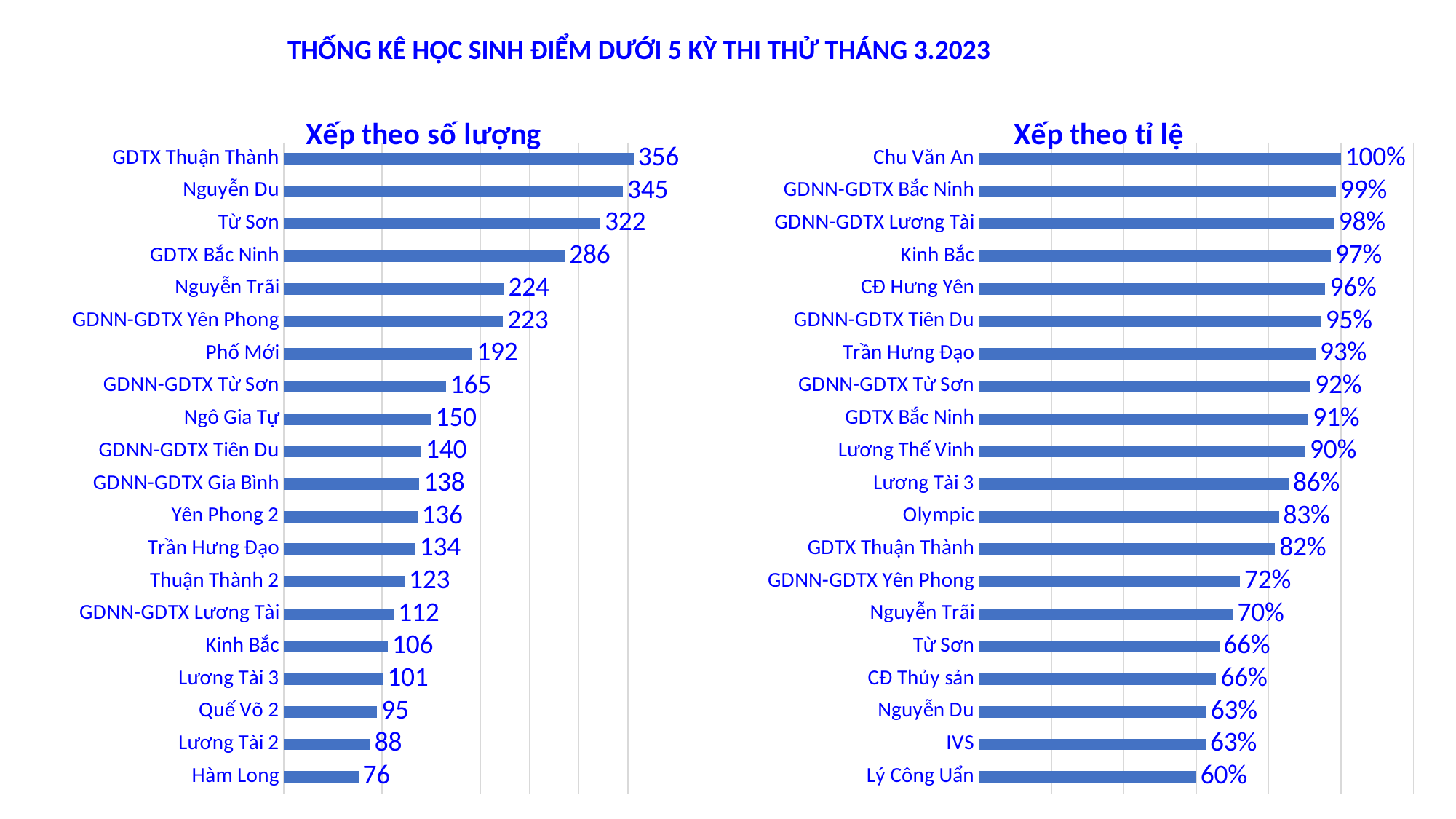
In the 'Xếp theo tỉ lệ' chart, which category has the highest value? Chu Văn An In the 'Xếp theo số lượng' chart, what is the value for Phố Mới? 192 What kind of chart is the 'Xếp theo tỉ lệ' chart? Bar chart In the 'Xếp theo tỉ lệ' chart, which is larger: the value for Kinh Bắc or the value for Nguyễn Trãi? Kinh Bắc In the 'Xếp theo tỉ lệ' chart, what is the value for Lương Thế Vinh? 90% In the 'Xếp theo tỉ lệ' chart, what is the value for Olympic? 83% In the 'Xếp theo số lượng' chart, what is the difference between the values for Từ Sơn and GDTX Bắc Ninh? 36 In the 'Xếp theo số lượng' chart, how many categories are shown? 20 In the 'Xếp theo số lượng' chart, what is the value for Nguyễn Du? 345 In the 'Xếp theo tỉ lệ' chart, which category has the lowest value? Lý Công Uẩn In the 'Xếp theo số lượng' chart, which category has the lowest value? Hàm Long In the 'Xếp theo số lượng' chart, which category has the highest value? GDTX Thuận Thành